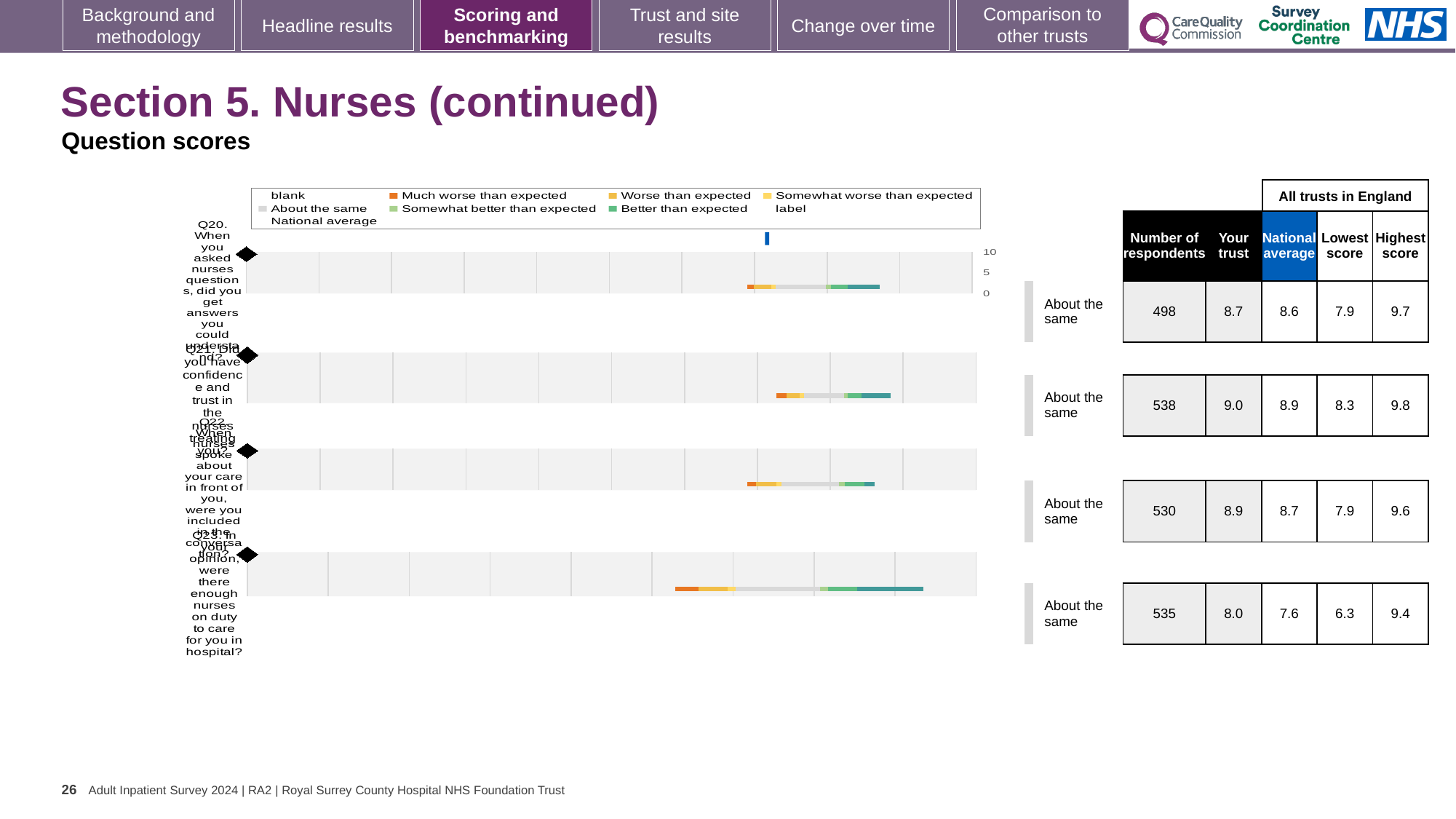
Which question has the highest 'Your trust' score in the table beside the chart? Q21 How many questions (rows) are plotted in the chart? 4 What benchmark category is shown for all four questions (Q20 to Q23)? About the same For Q20, which is larger: the 'Your trust' score or the national average? Your trust According to the table beside the chart, what is the national average for Q23 (enough nurses on duty)? 7.6 What kind of chart is used to show the question scores for Q20 to Q23? bar chart What colour does the legend use for 'Much worse than expected'? orange How many entries does the chart legend list? 9 According to the table beside the chart, what is the 'Your trust' score for Q21 (confidence and trust in the nurses)? 9.0 Which question has the lowest 'Your trust' score in the table beside the chart? Q23 For Q23, what is the difference between the highest score and the lowest score across all trusts in England? 3.1 According to the table beside the chart, how many respondents answered Q22? 530